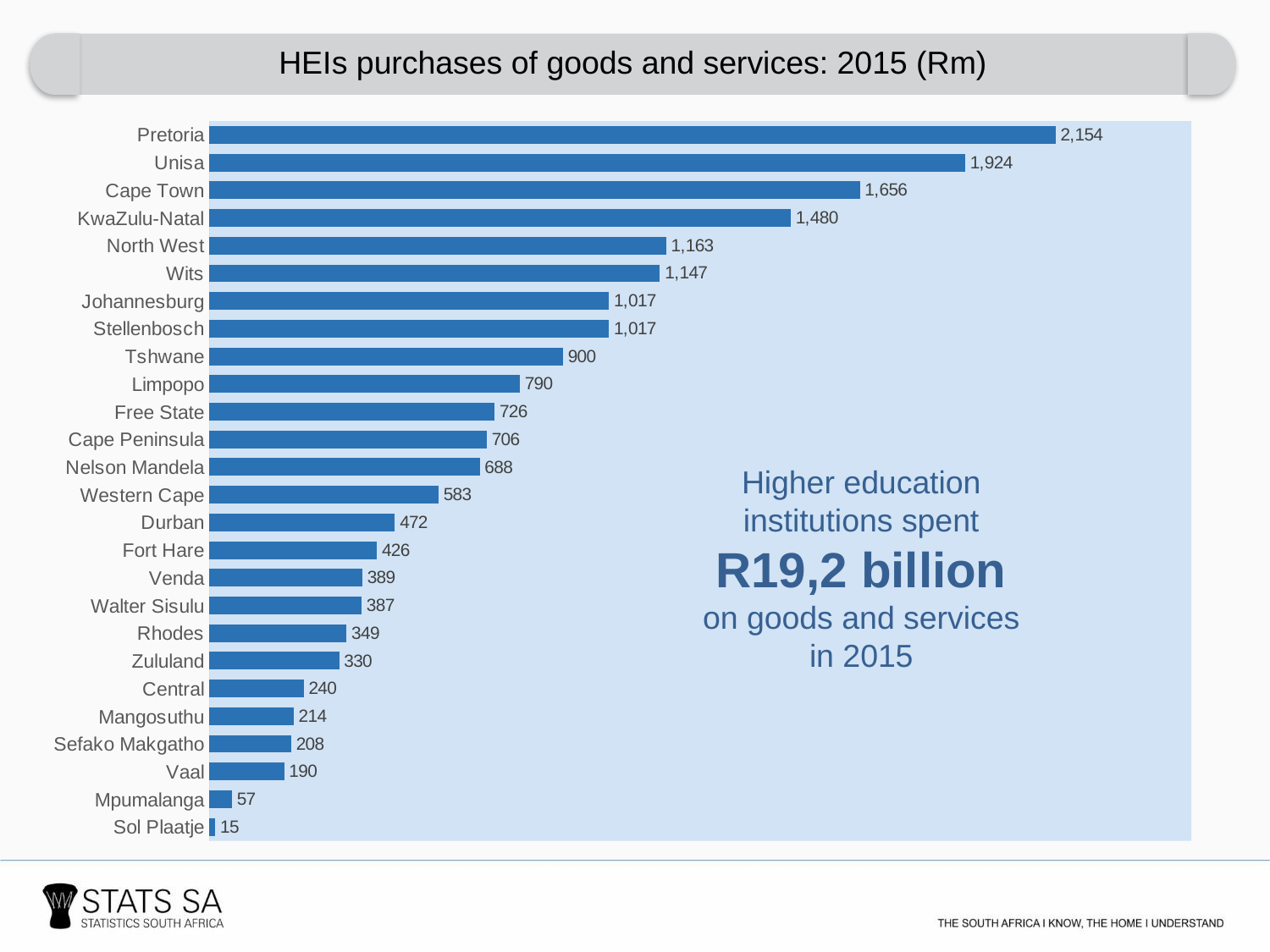
What is the value for Walter Sisulu? 387 Which has a larger value, Limpopo or Free State? Limpopo Which has a larger value, Vaal or Central? Central What is the value for Pretoria? 2,154 What is the title of the chart? HEIs purchases of goods and services: 2015 (Rm) Which institution has the highest value? Pretoria How many institutions are shown in the chart? 26 Which institution has the lowest value? Sol Plaatje What is the value for Tshwane? 900 What is the difference between the values for Cape Town and KwaZulu-Natal? 176 What kind of chart is shown on the slide? Bar chart What is the difference between the values for Pretoria and Unisa? 230